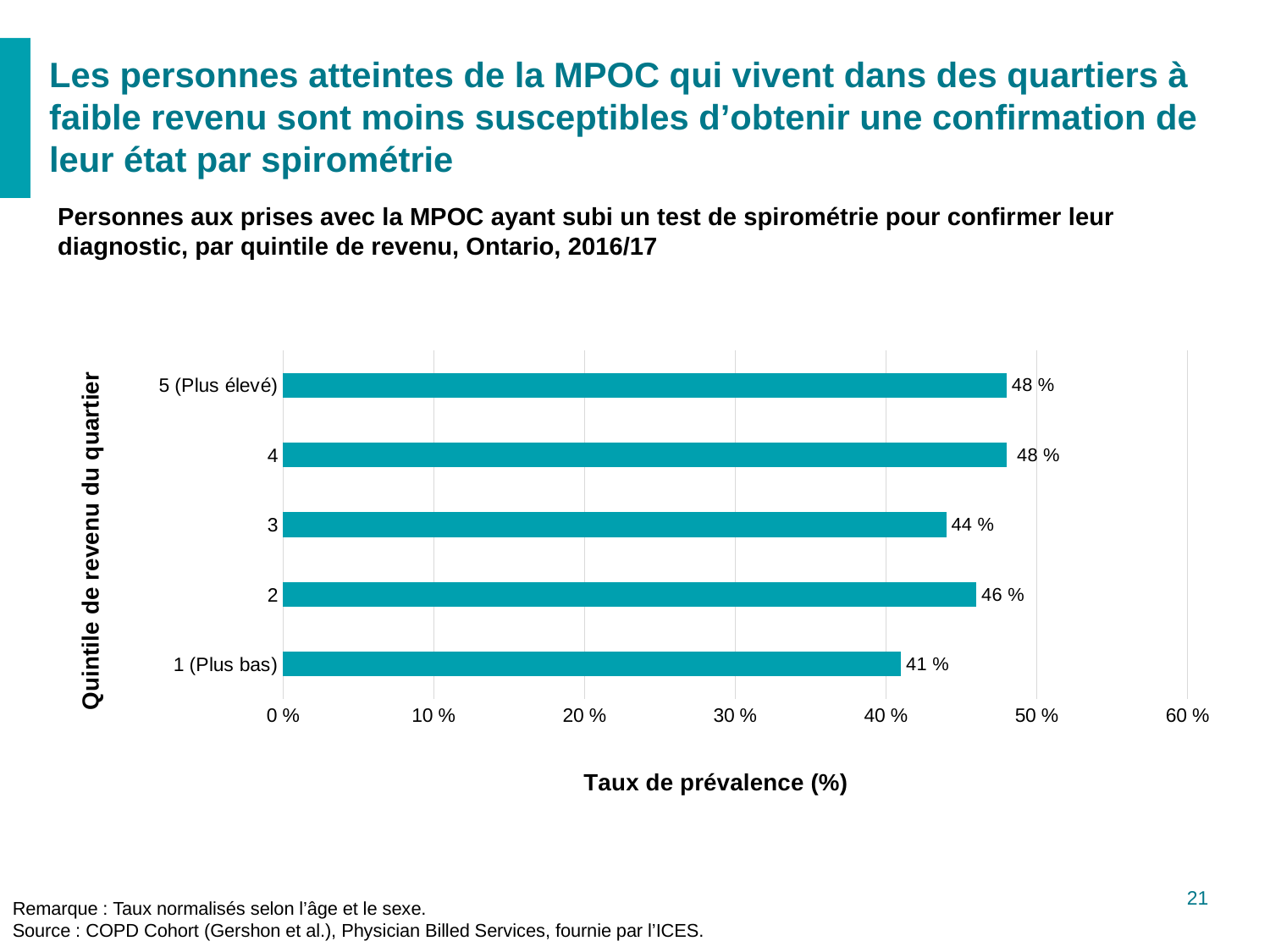
What is the value for quintile 2? 46 % Which is larger, the value for quintile 2 or the value for quintile 3? quintile 2 What is the value for quintile 5 (Plus élevé)? 48 % How many income quintiles are shown in the chart? 5 What is the label of the horizontal axis? Taux de prévalence (%) Which quintile has the lowest value? 1 (Plus bas) What is the difference between the values for quintile 2 and quintile 3? 2 % What is the value for quintile 1 (Plus bas)? 41 % What is the difference between the values for quintile 5 (Plus élevé) and quintile 1 (Plus bas)? 7 % Is the value for quintile 1 (Plus bas) greater or less than 50 %? less What kind of chart is shown on the slide? bar chart What is the value for quintile 3? 44 %